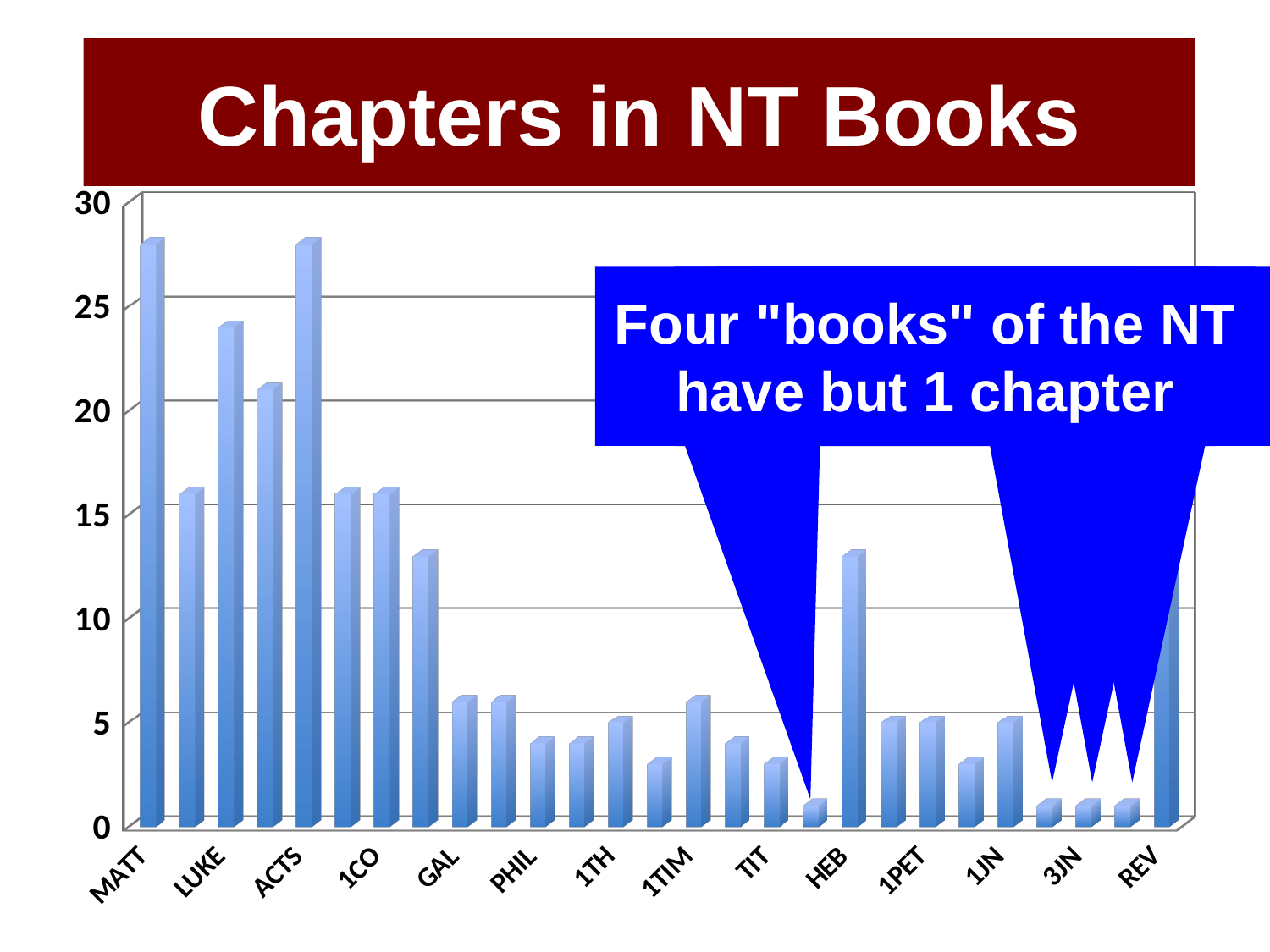
Which has the larger value, GAL or REV? REV Which has the larger value, LUKE or HEB? LUKE What kind of chart is shown on the slide? bar chart What is the title of the chart? Chapters in NT Books How many bars are plotted in the chart? 27 Is the value for TIT greater or less than 5? less Is the value for 3JN greater or less than 5? less Is the value for LUKE greater or less than 20? greater According to the callout on the chart, how many NT books have only 1 chapter? Four